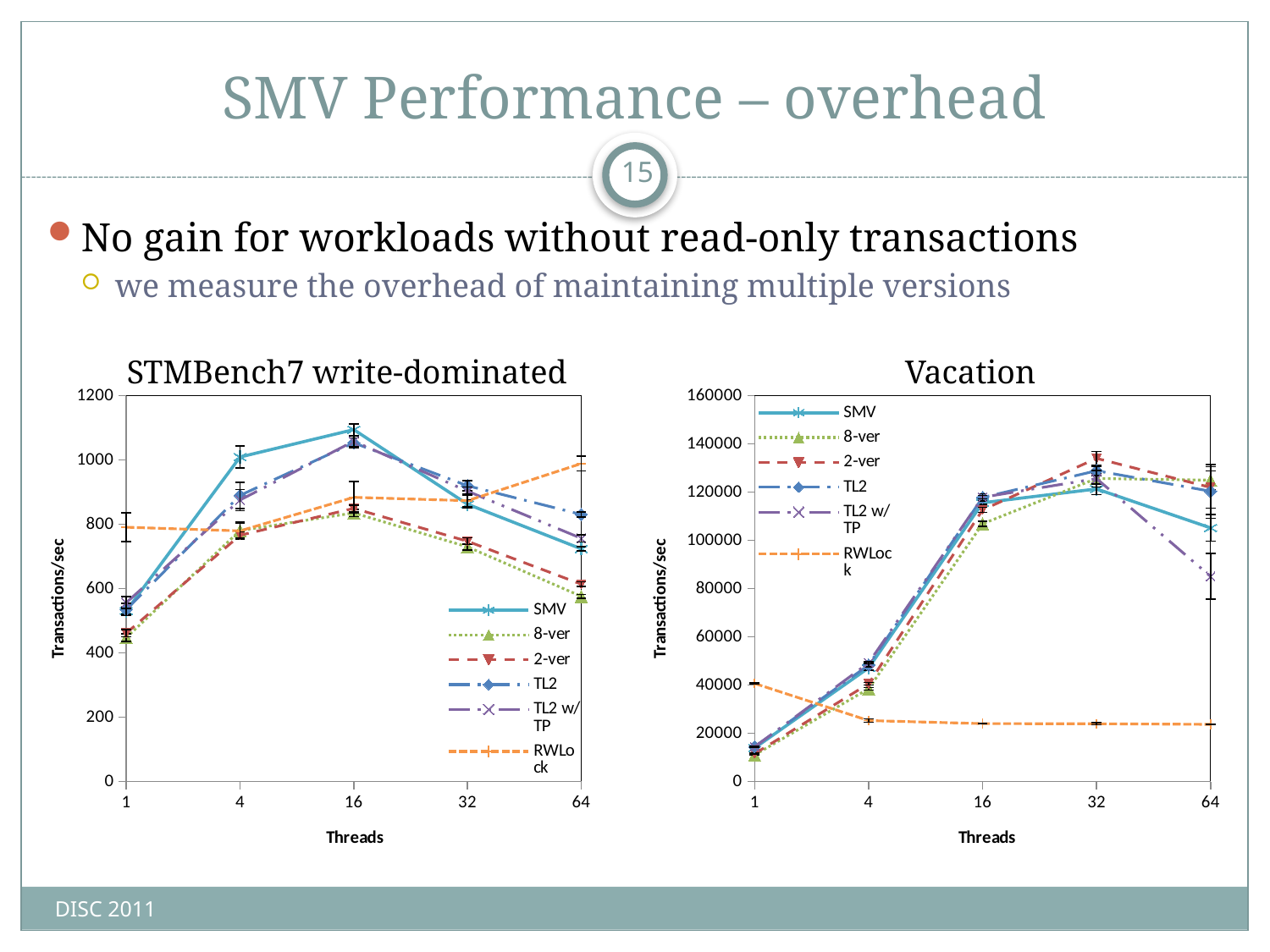
In the Vacation chart, is the value for RWLock at 64 threads greater or less than 40000? less In the STMBench7 write-dominated chart, does the SMV series rise or fall from 16 threads to 64 threads? fall In the Vacation chart, is the value for SMV at 16 threads greater or less than 100000? greater In the Vacation chart, which series has the lowest value at 64 threads? RWLock In the Vacation chart, which is larger at 1 thread: SMV or RWLock? RWLock What is the y-axis label of the Vacation chart? Transactions/sec In the STMBench7 write-dominated chart, is the value for SMV at 16 threads greater or less than 1000? greater What kind of chart is the STMBench7 write-dominated chart? line chart In the STMBench7 write-dominated chart, which series has the highest value at 64 threads? RWLock How many thread counts are plotted along the x axis of the STMBench7 write-dominated chart? 5 How many series does the legend of the Vacation chart list? 6